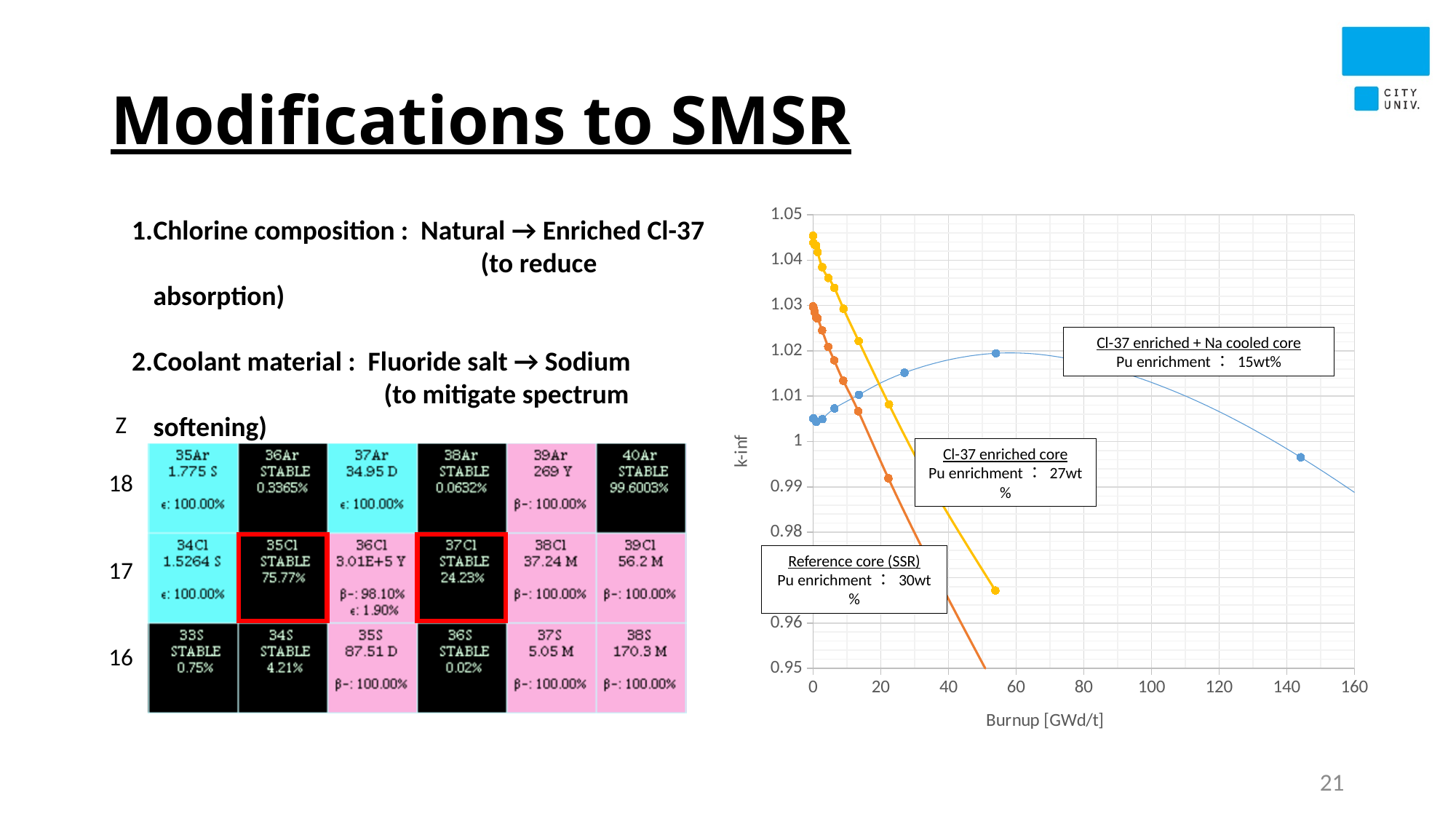
What kind of chart is shown on the slide? line chart Is the k-inf value for the Cl-37 enriched core at a burnup of 0 GWd/t greater or less than 1.04? greater At a burnup of 40 GWd/t, which has the higher k-inf: the Reference core (SSR) or the Cl-37 enriched + Na cooled core? Cl-37 enriched + Na cooled core What is the label of the x axis of the chart? Burnup [GWd/t] How many data series are plotted on the k-inf versus Burnup chart? 3 Which series extends to the highest burnup on the chart? Cl-37 enriched + Na cooled core Does k-inf for the Reference core (SSR) rise or fall as burnup increases? fall Is the k-inf value for the Cl-37 enriched + Na cooled core at a burnup of 140 GWd/t greater or less than 1? less Is the k-inf value for the Reference core (SSR) at a burnup of 20 GWd/t greater or less than 1? less At a burnup of 0 GWd/t, which has the higher k-inf: the Cl-37 enriched core or the Cl-37 enriched + Na cooled core? Cl-37 enriched core What is the label of the y axis of the chart? k-inf